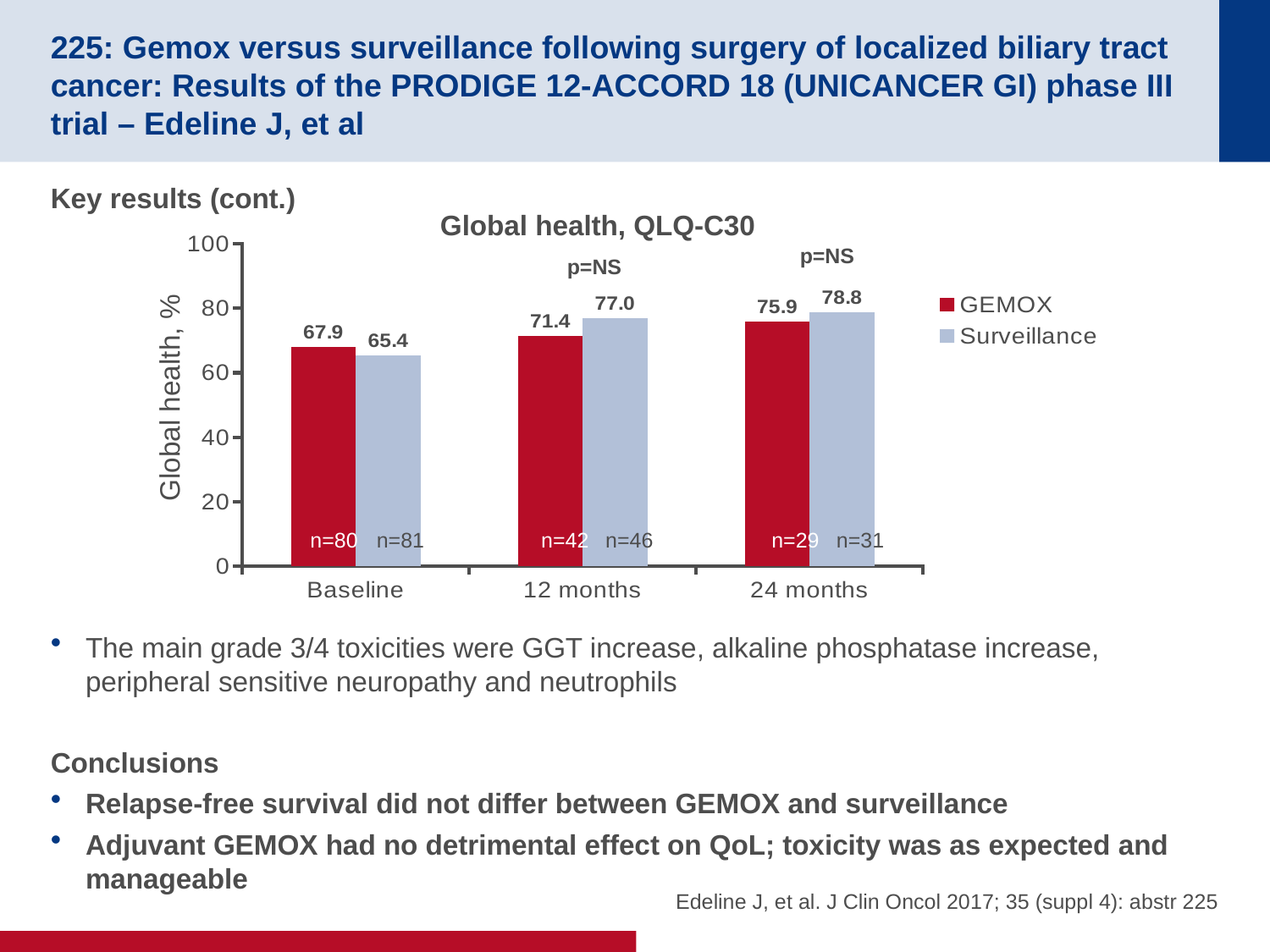
How many series does the legend list? 2 What is the difference between the Surveillance and GEMOX values at 12 months? 5.6 How many time points are shown on the x axis? 3 Which is larger at baseline, the GEMOX value or the Surveillance value? GEMOX What is the global health value for Surveillance at 24 months? 78.8 Is the GEMOX value at 24 months greater or less than 80? less Does the Surveillance global health value rise or fall from baseline to 24 months? rise What kind of chart is shown? bar chart At which time point is the GEMOX global health value highest? 24 months What is the global health value for Surveillance at 12 months? 77.0 What is the global health value for GEMOX at baseline? 67.9 At which time point is the Surveillance global health value lowest? Baseline